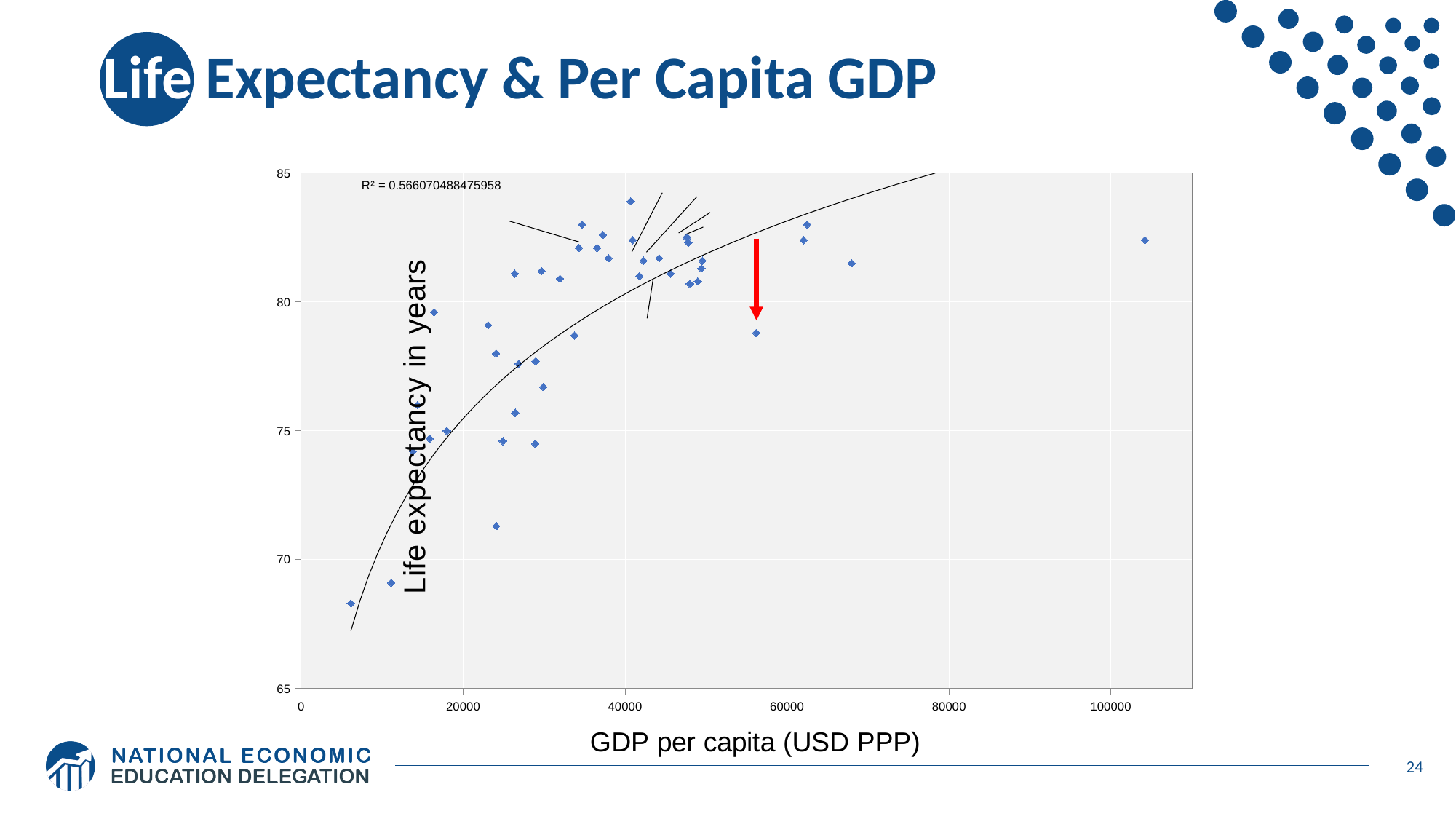
Is the life expectancy of the point marked by the red arrow greater or less than 80? less As GDP per capita increases along the x axis, does life expectancy generally rise or fall? rise What R² value is printed on the chart? R² = 0.566070488475958 Is the life expectancy of the lowest point on the chart greater or less than 70? less Is the GDP per capita of the point marked by the red arrow greater or less than 40000? greater What is the label of the vertical axis of the chart? Life expectancy in years What kind of chart is shown on the slide? scatter chart What is the highest value shown on the vertical axis of the chart? 85